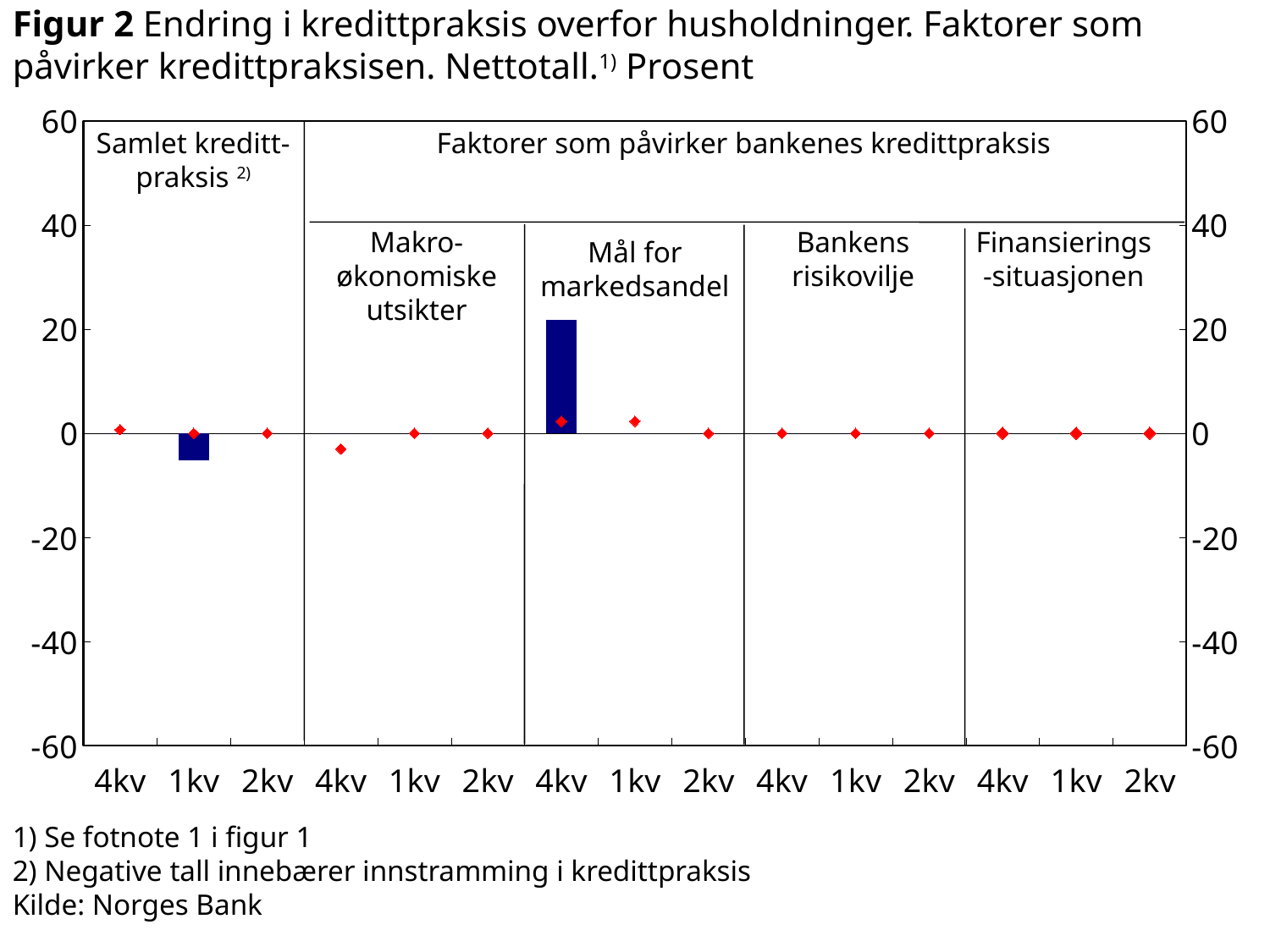
Is the bar for 4kv in the 'Mål for markedsandel' panel greater or less than 0? greater Which is larger: the bar for 4kv in 'Mål for markedsandel' or the bar for 1kv in 'Samlet kredittpraksis'? 4kv in Mål for markedsandel What is the maximum value shown on the y axis? 60 How many factor panels are shown under 'Faktorer som påvirker bankenes kredittpraksis'? 4 Is the bar for 1kv in the 'Samlet kredittpraksis' panel greater or less than -20? greater In which panel does the tallest bar appear? Mål for markedsandel Is the bar for 1kv in the 'Samlet kredittpraksis' panel greater or less than 0? less What kind of chart is shown in Figur 2? combination bar and line chart (bars with red diamond markers) How many quarter labels (4kv, 1kv, 2kv) appear along the x axis in total? 15 In which panel does the only bar below zero appear? Samlet kredittpraksis What is the source given for the chart? Norges Bank